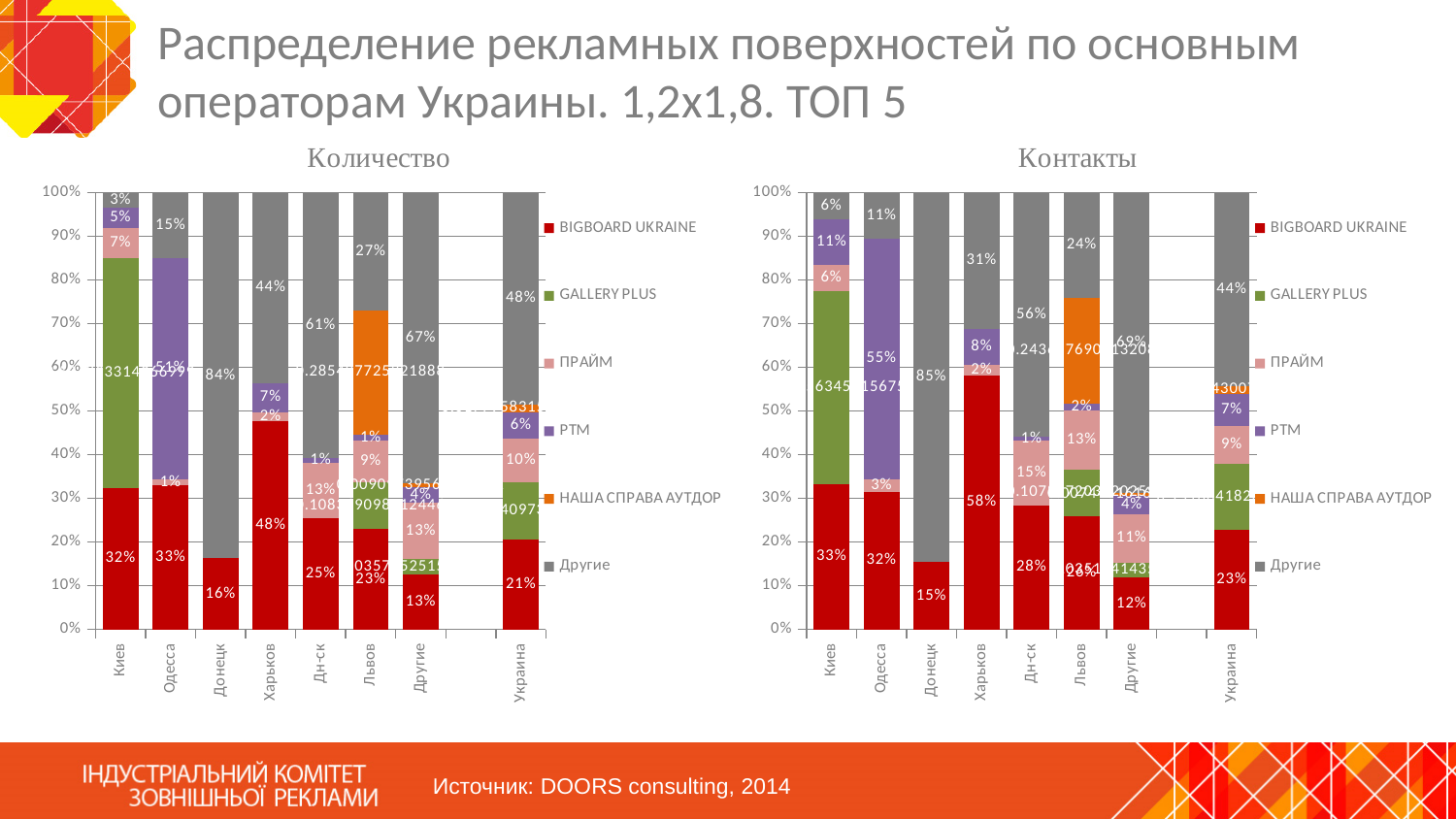
What type of chart is the Количество chart? Stacked bar chart On the Контакты chart, which category has the lowest BIGBOARD UKRAINE share? Другие On the Количество chart, which city has the highest BIGBOARD UKRAINE share? Харьков On the Количество chart, what is the BIGBOARD UKRAINE share for Харьков? 48% On the Контакты chart, what is the BIGBOARD UKRAINE share for Харьков? 58% On the Количество chart, what is the difference between the BIGBOARD UKRAINE shares of Харьков and Донецк? 32% On the Количество chart, what is the BIGBOARD UKRAINE share for Украина? 21% On the Контакты chart, what is the Другие share for Украина? 44% On the Контакты chart, what is the Другие share for Донецк? 85% On the Количество chart, what is the Другие share for Донецк? 84% How many series does the legend of the Контакты chart list? 6 On the Контакты chart, which is larger: the BIGBOARD UKRAINE share for Киев or for Одесса? Киев